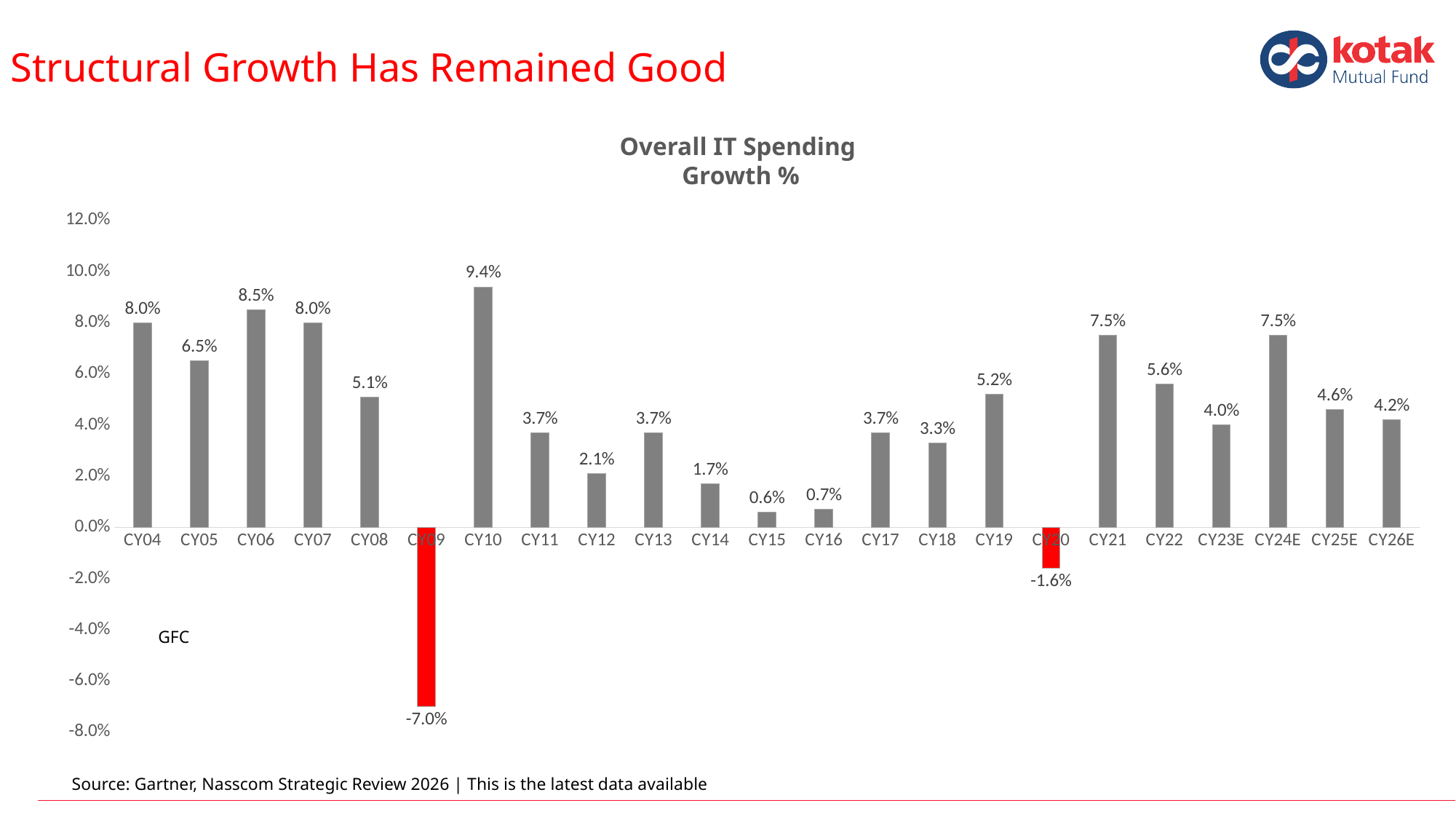
Which is larger, the growth % for CY19 or CY18? CY19 What is the difference between the growth % for CY21 and CY22? 1.9% Which year has the highest Overall IT Spending Growth %? CY10 Which two bars are coloured red in the chart? CY09 and CY20 What is the Overall IT Spending Growth % for CY10? 9.4% What kind of chart is shown on the slide? Bar chart Do the values rise or fall from CY10 to CY12? Fall What is the Overall IT Spending Growth % for CY26E? 4.2% What is the title of the chart? Overall IT Spending Growth % Which year has the lowest Overall IT Spending Growth %? CY09 How many years are shown on the x axis of the chart? 23 What is the Overall IT Spending Growth % for CY20? -1.6%